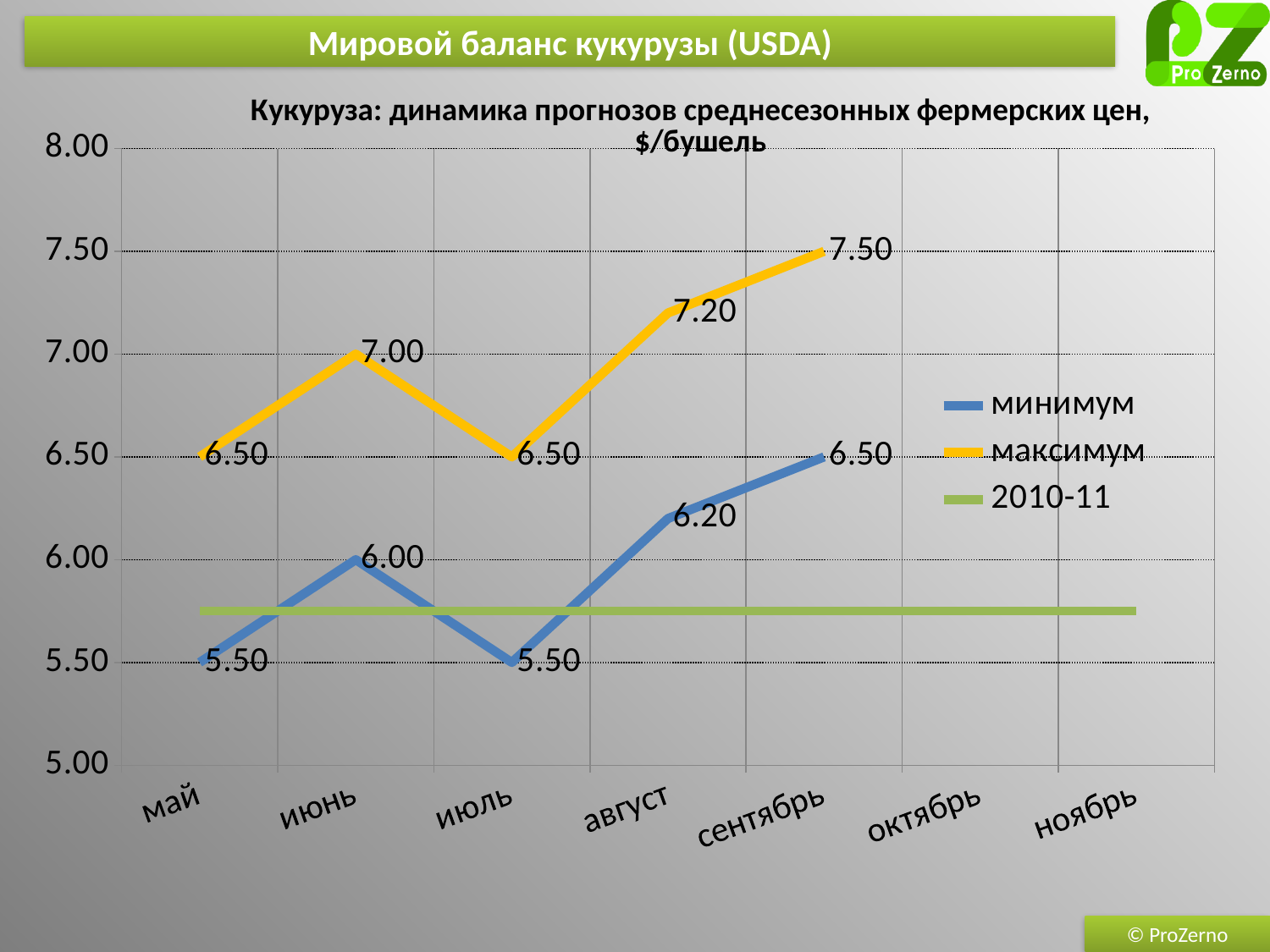
How many months are shown on the x axis? 7 In which month does the максимум series reach its highest value? сентябрь Is the value of the 2010-11 line greater or less than 6.00? less Which is larger: минимум in август or минимум in июнь? август What is the lowest value shown for the минимум series? 5.50 What is the value of максимум for август? 7.20 Does the максимум series rise or fall from июль to сентябрь? rises What is the value of минимум for июнь? 6.00 What is the value of минимум for сентябрь? 6.50 What kind of chart is shown on the slide? line chart What is the difference between максимум and минимум in сентябрь? 1.00 How many series does the legend list? 3